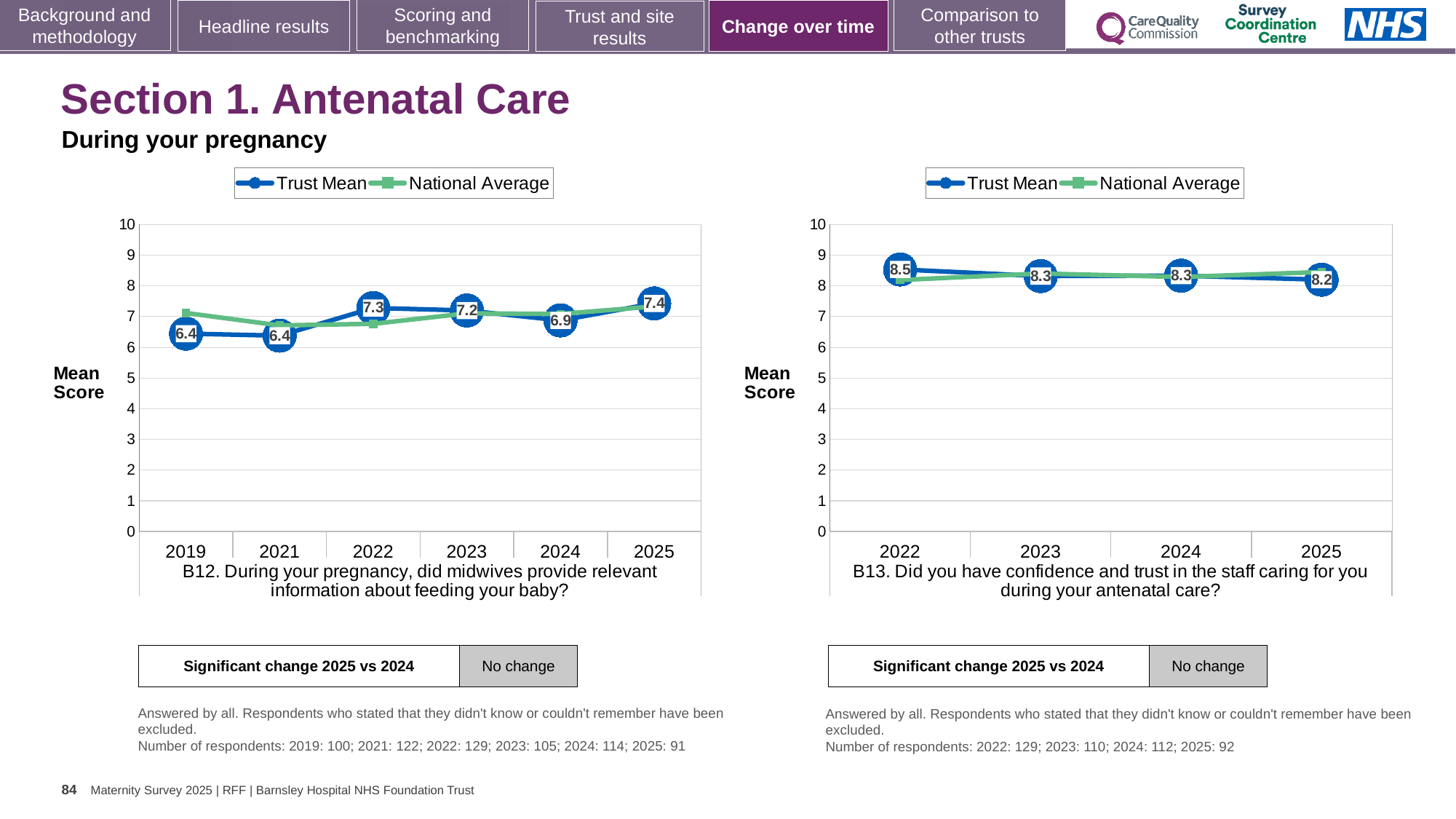
On the B12 chart (left), is the Trust Mean score for 2021 greater or less than 7? less What kind of chart is the B12 chart (left)? line chart How many series does the legend of the B13 chart (right) list? 2 On the B13 chart (right), is the Trust Mean score for 2022 larger than the Trust Mean score for 2025? Yes On the B12 chart (left), what is the Trust Mean score for 2025? 7.4 On the B13 chart (right), what is the Trust Mean score for 2022? 8.5 On the B13 chart (right), which year has the lowest Trust Mean score? 2025 On the B13 chart (right), does the Trust Mean score rise or fall from 2022 to 2025? fall On the B12 chart (left), what is the difference between the Trust Mean scores for 2022 and 2024? 0.4 On the B12 chart (left), which year has the highest Trust Mean score? 2025 On the B12 chart (left), how many years are plotted on the x axis? 6 On the B12 chart (left), what is the Trust Mean score for 2019? 6.4